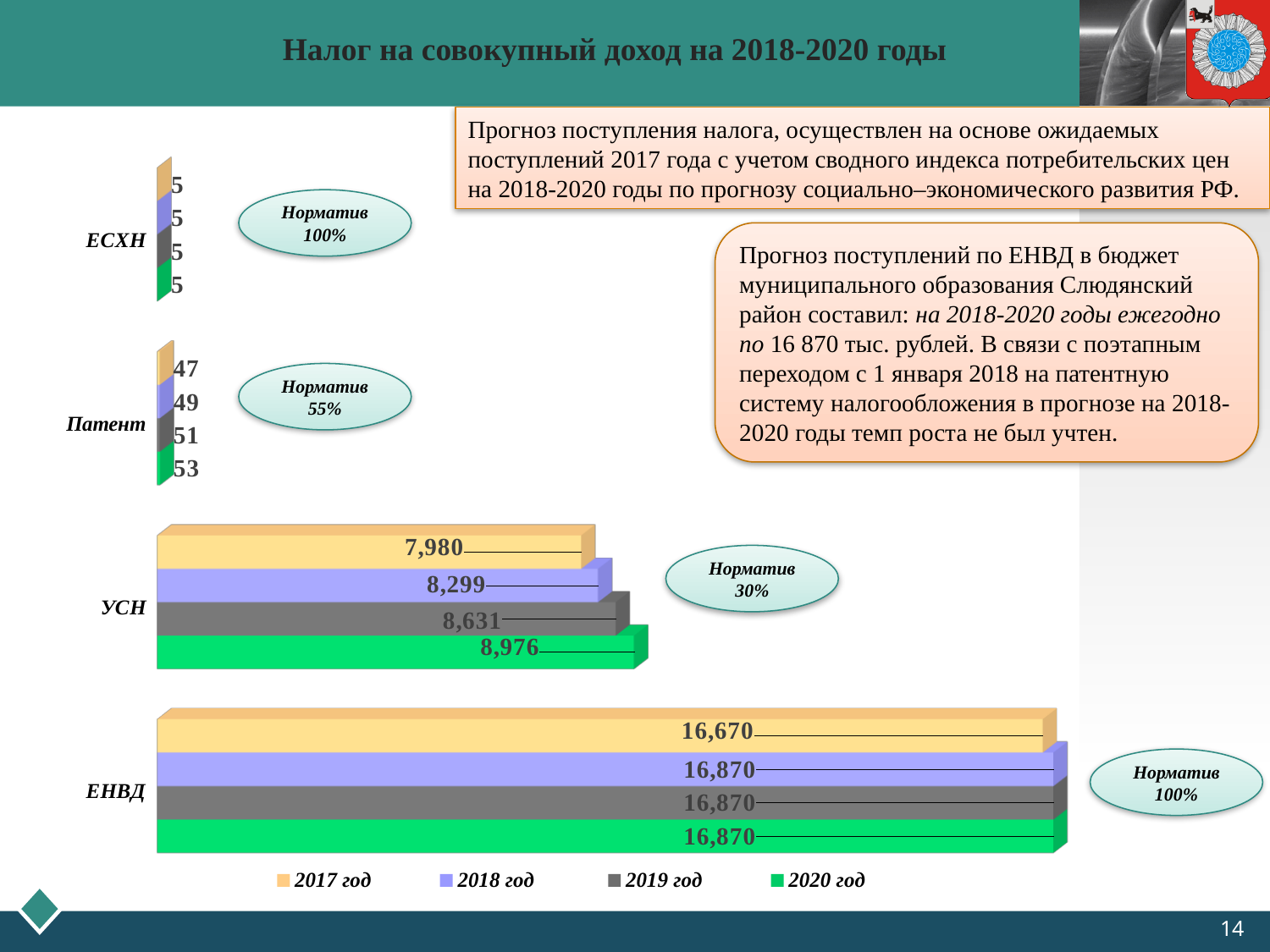
What is the difference between the 2020 год and 2017 год values for УСН? 996 What kind of chart is shown on the slide? Bar chart What is the value for УСН in the 2020 год series? 8,976 What is the difference between the 2018 год and 2017 год values for ЕНВД? 200 Which is larger for Патент: the 2017 год value or the 2020 год value? 2020 год What is the value for Патент in the 2018 год series? 49 What is the value for ЕСХН in the 2019 год series? 5 How many series does the legend list? 4 What is the value for ЕНВД in the 2017 год series? 16,670 Which category has the lowest value in the 2017 год series? ЕСХН How many categories are shown on the chart? 4 Which category has the highest value in the 2020 год series? ЕНВД